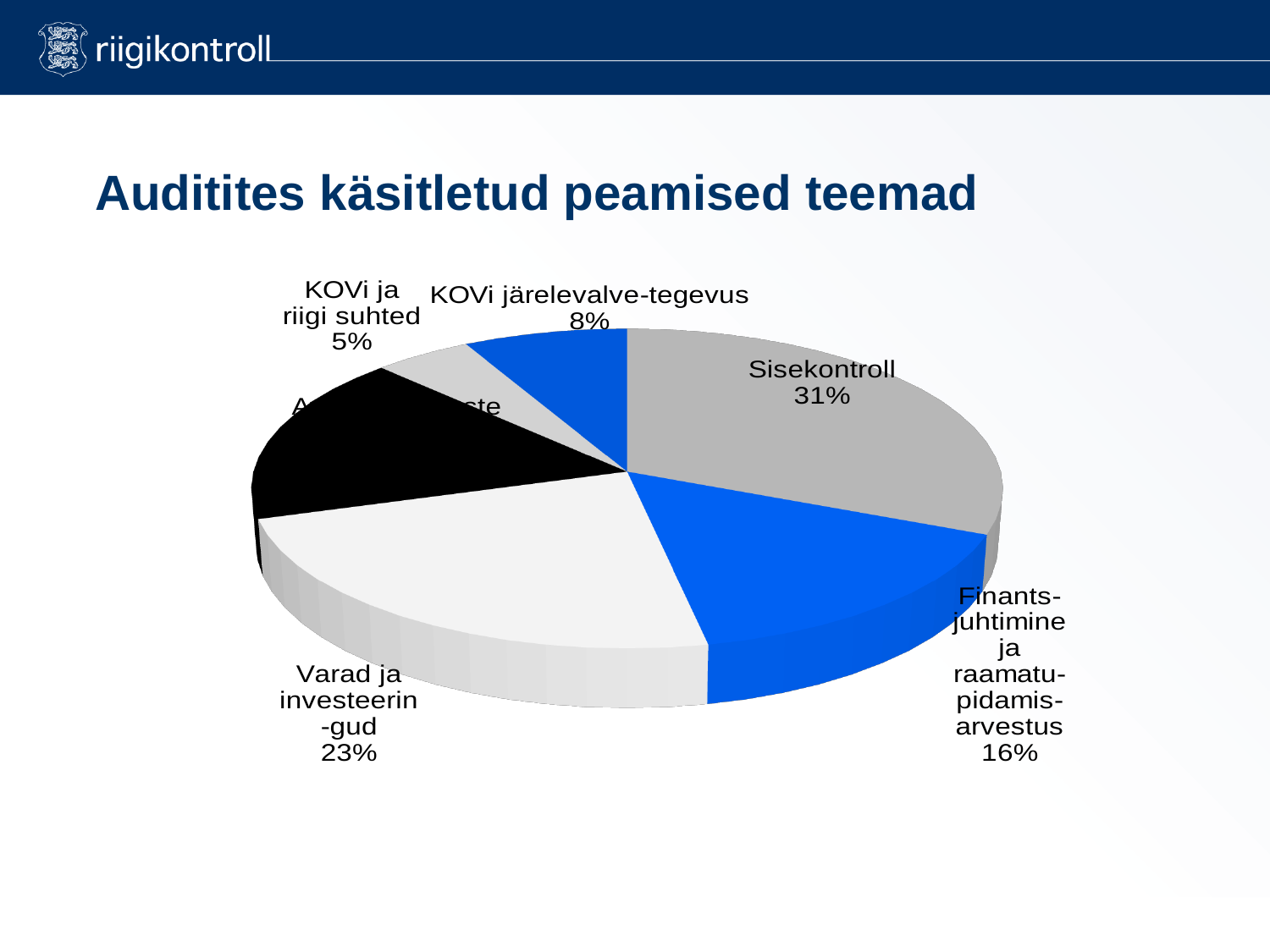
What percentage is shown for Finantsjuhtimine ja raamatupidamisarvestus? 16% What percentage is shown for KOVi ja riigi suhted? 5% What percentage is shown for KOVi järelevalve-tegevus? 8% How many percentage points larger is Sisekontroll than Varad ja investeeringud? 8 Which slice of the pie is the largest? Sisekontroll What percentage is shown for Varad ja investeeringud? 23% How many slices does the pie chart have? 6 Which is larger: Varad ja investeeringud or Finantsjuhtimine ja raamatupidamisarvestus? Varad ja investeeringud What share of the pie does Sisekontroll have? 31% Which labelled slice of the pie is the smallest? KOVi ja riigi suhted What kind of chart is shown on the slide? pie chart What is the title of the slide above the chart? Auditites käsitletud peamised teemad